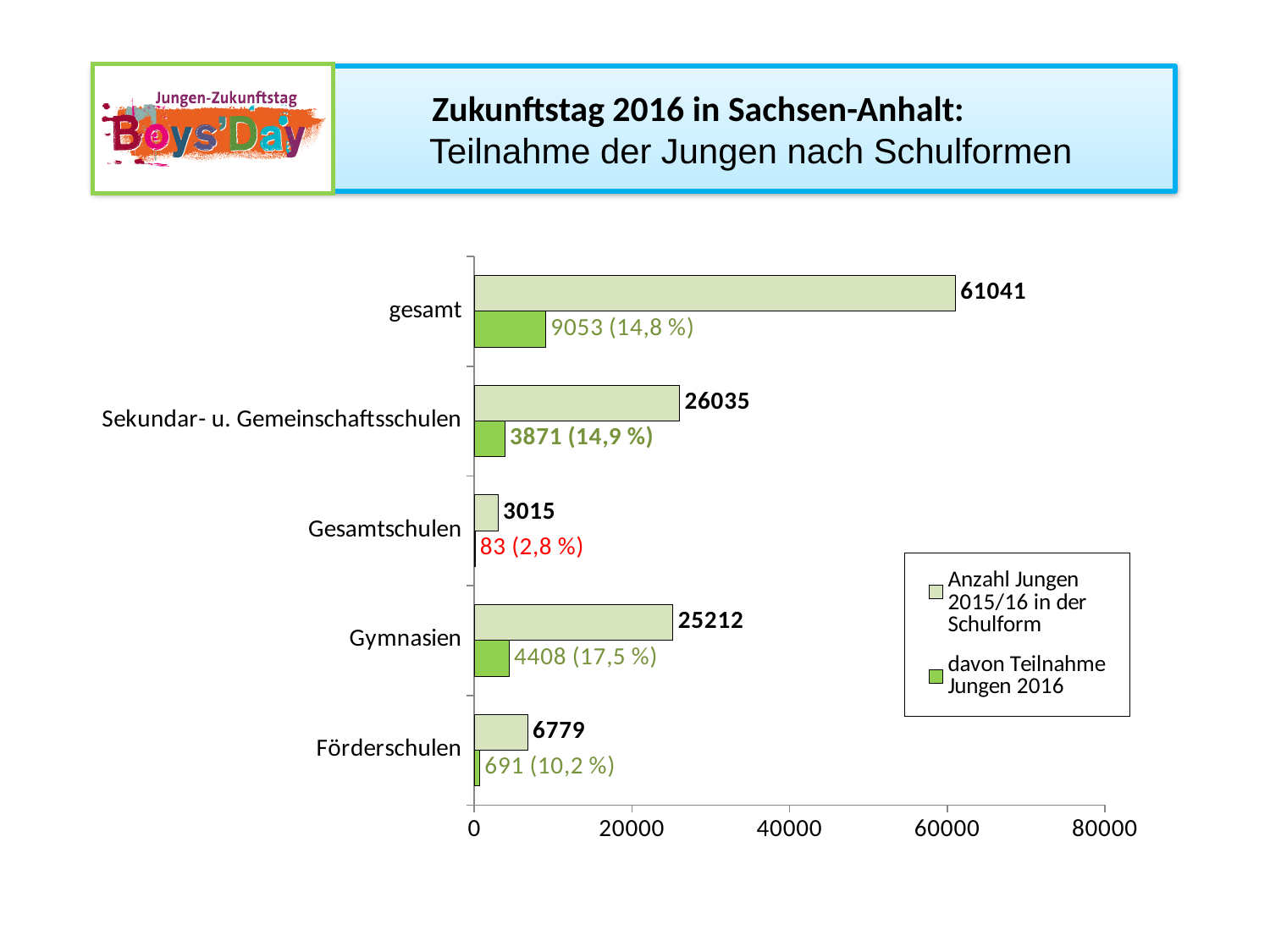
Excluding 'gesamt', which school type has the highest 'Anzahl Jungen 2015/16 in der Schulform'? Sekundar- u. Gemeinschaftsschulen What is the value of 'Anzahl Jungen 2015/16 in der Schulform' for Förderschulen? 6779 What is the data label for 'davon Teilnahme Jungen 2016' for Sekundar- u. Gemeinschaftsschulen? 3871 (14,9 %) What kind of chart is shown on the slide? bar chart How many series does the legend list? 2 Which school type has the lowest 'davon Teilnahme Jungen 2016' value? Gesamtschulen Which is larger: 'davon Teilnahme Jungen 2016' for Gymnasien or for Sekundar- u. Gemeinschaftsschulen? Gymnasien What is the data label for 'davon Teilnahme Jungen 2016' for Gesamtschulen? 83 (2,8 %) How many categories are shown on the vertical axis of the chart? 5 Is the 'Anzahl Jungen 2015/16 in der Schulform' value for gesamt greater or less than 60000? greater What is the value of 'Anzahl Jungen 2015/16 in der Schulform' for Gymnasien? 25212 What is the difference between 'Anzahl Jungen 2015/16 in der Schulform' for Sekundar- u. Gemeinschaftsschulen and Gymnasien? 823